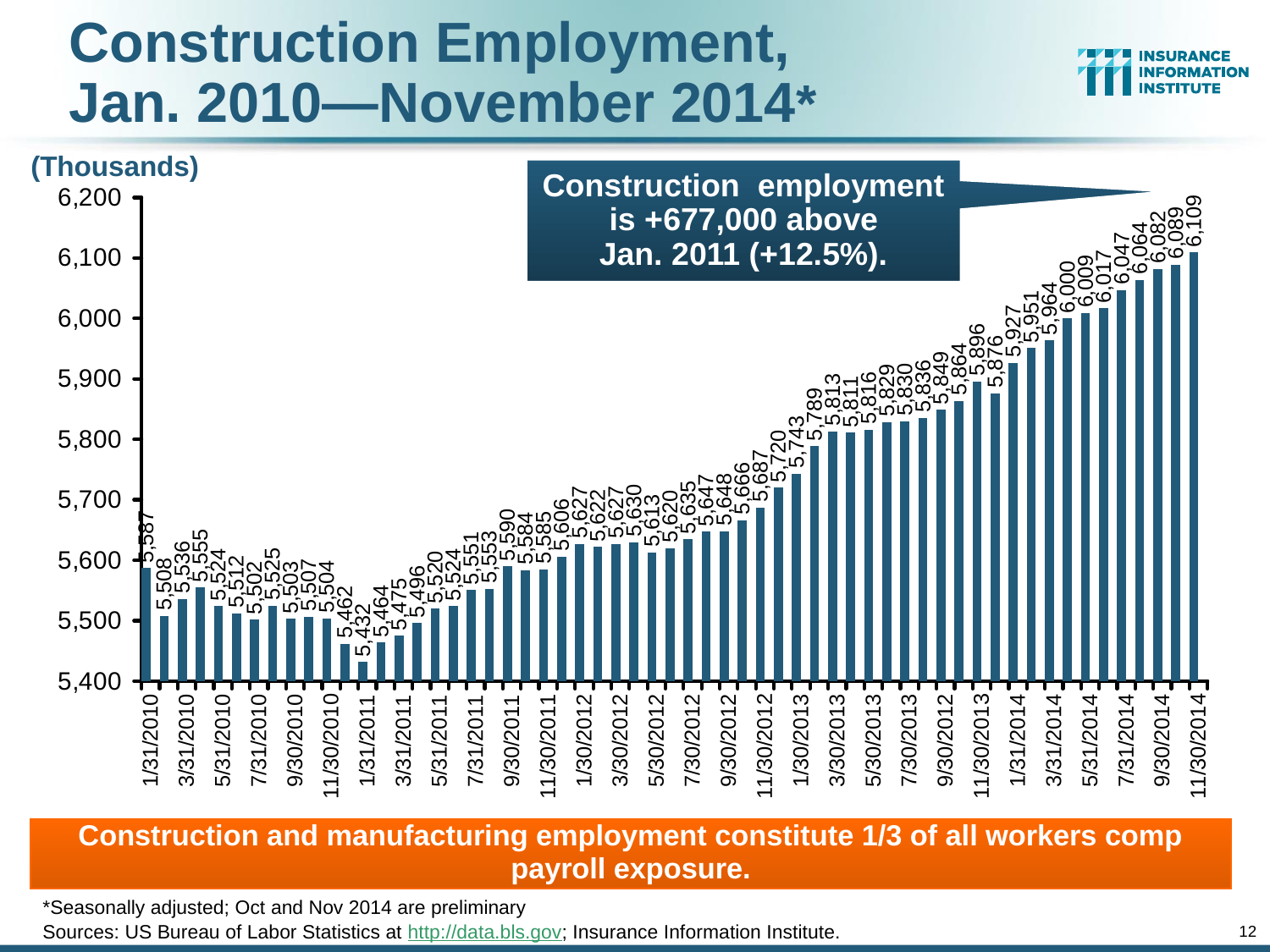
Which is larger, the construction employment value for 1/31/2010 or the value for 1/30/2012? 1/30/2012 What type of chart is used to show construction employment on this slide? Bar chart Which month has the lowest construction employment value on the chart? 1/31/2011 What was construction employment (in thousands) on 11/30/2014? 6,109 Which month has the highest construction employment value on the chart? 11/30/2014 What is the difference between the construction employment value for 11/30/2014 and the value for 1/31/2011? 677 What was construction employment (in thousands) on 1/30/2013? 5,743 What was construction employment (in thousands) on 1/31/2010? 5,587 What is the overall trend in construction employment from 1/31/2011 to 11/30/2014? Rising Is the construction employment value for 1/31/2014 greater or less than 6,000? less According to the callout box on the chart, by how much is construction employment above Jan. 2011? +677,000 (+12.5%) What was construction employment (in thousands) on 1/31/2011? 5,432